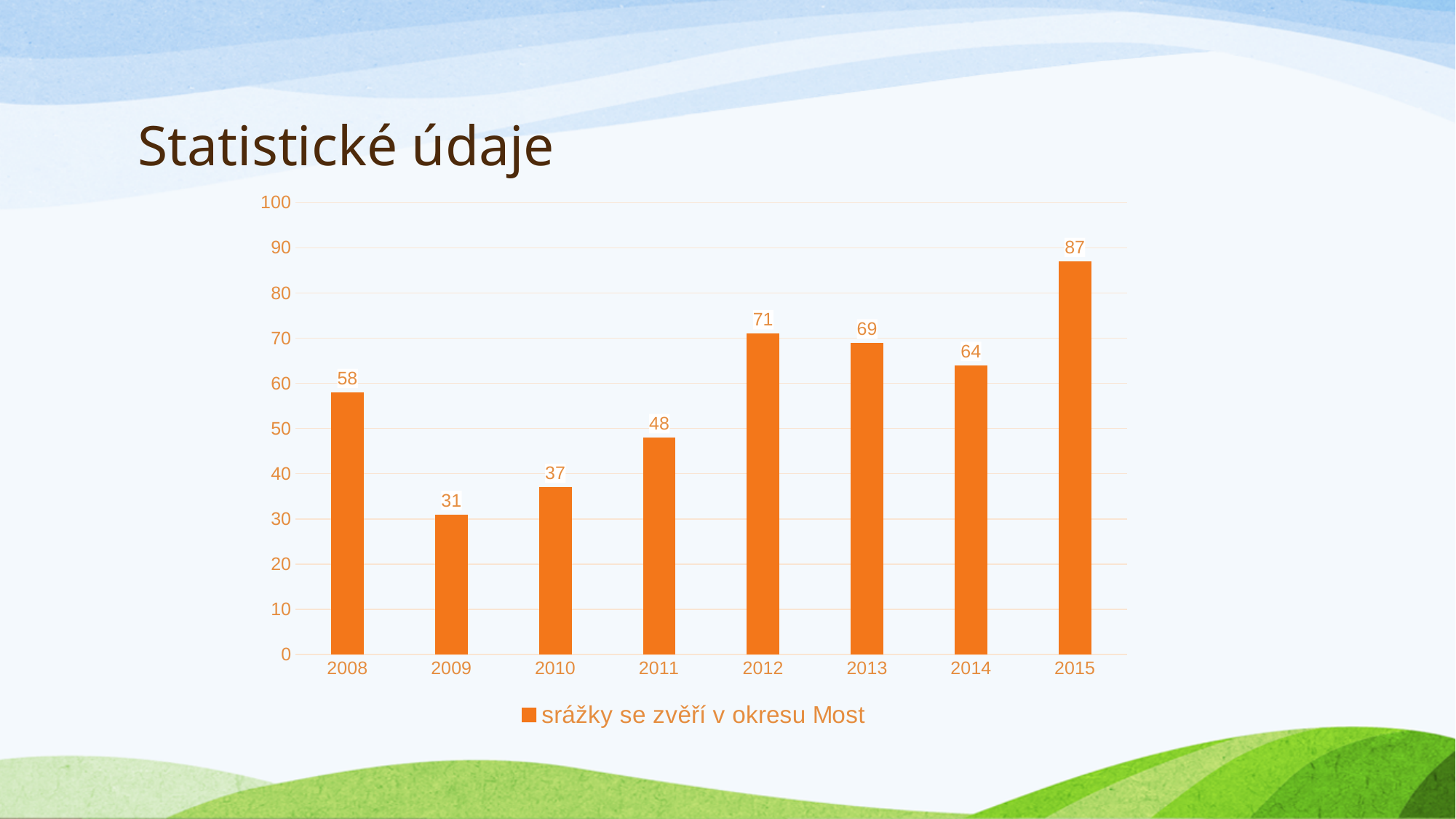
What is the value for 2009? 31 What is the legend entry for the series? srážky se zvěří v okresu Most Which is larger, the value for 2013 or the value for 2014? 2013 Which year has the highest value? 2015 How many years are shown on the x axis? 8 Is the value for 2011 greater or less than 50? less Do the values rise or fall from 2009 to 2012? rise What is the value for 2012? 71 What is the difference between the values for 2015 and 2008? 29 What kind of chart is shown? bar chart How many series does the legend list? 1 Which year has the lowest value? 2009